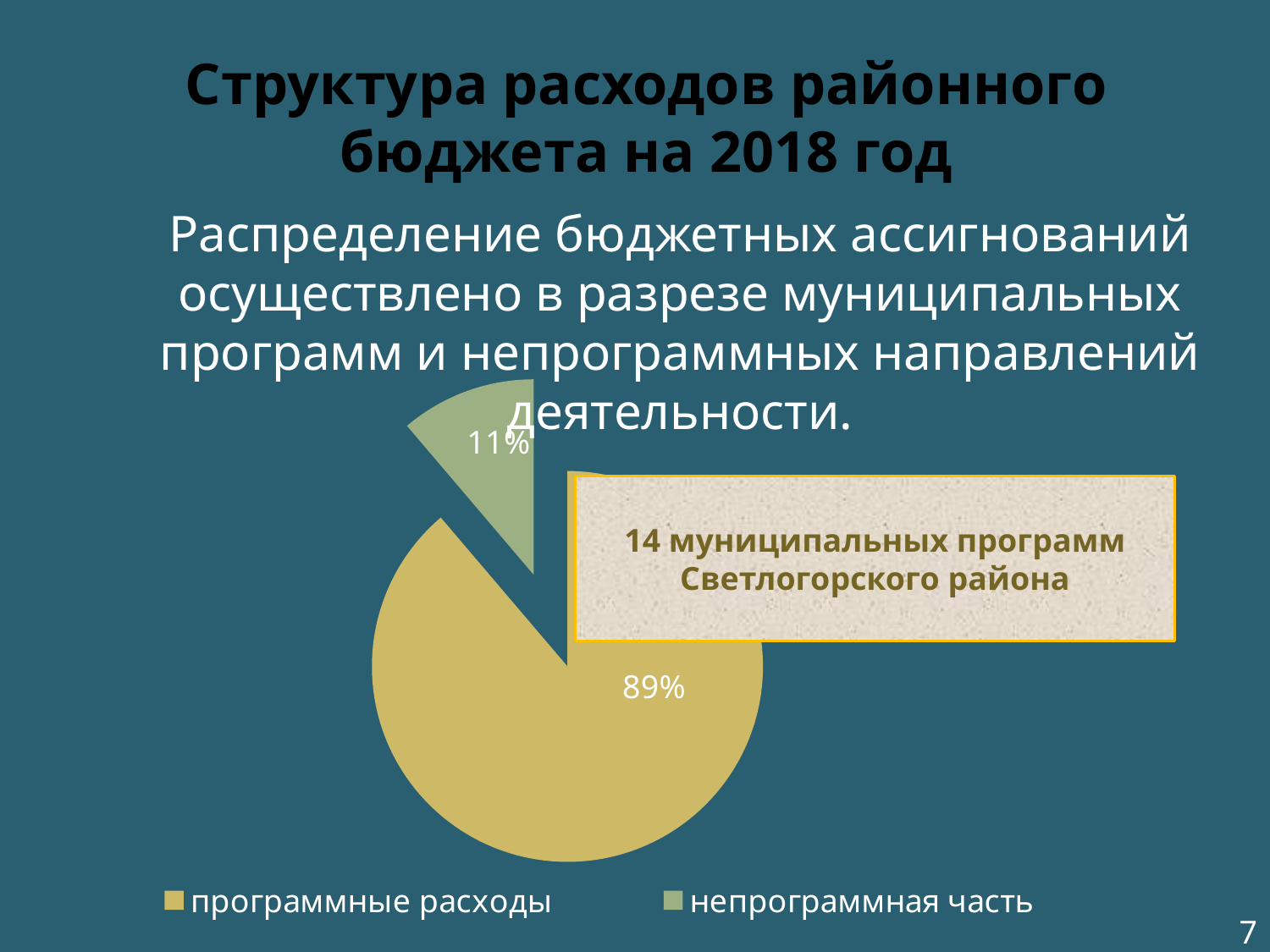
What kind of chart is shown on the slide? pie chart Which is larger: "программные расходы" or "непрограммная часть"? программные расходы What is the title of the slide containing the chart? Структура расходов районного бюджета на 2018 год What is the difference in percentage points between "программные расходы" and "непрограммная часть"? 78 What share of the pie does "непрограммная часть" take? 11% How many entries does the legend list? 2 What share of the pie does "программные расходы" take? 89% What colour is the "непрограммная часть" slice? green Which slice of the pie is the largest? программные расходы Which slice of the pie is the smallest? непрограммная часть How many slices does the pie chart have? 2